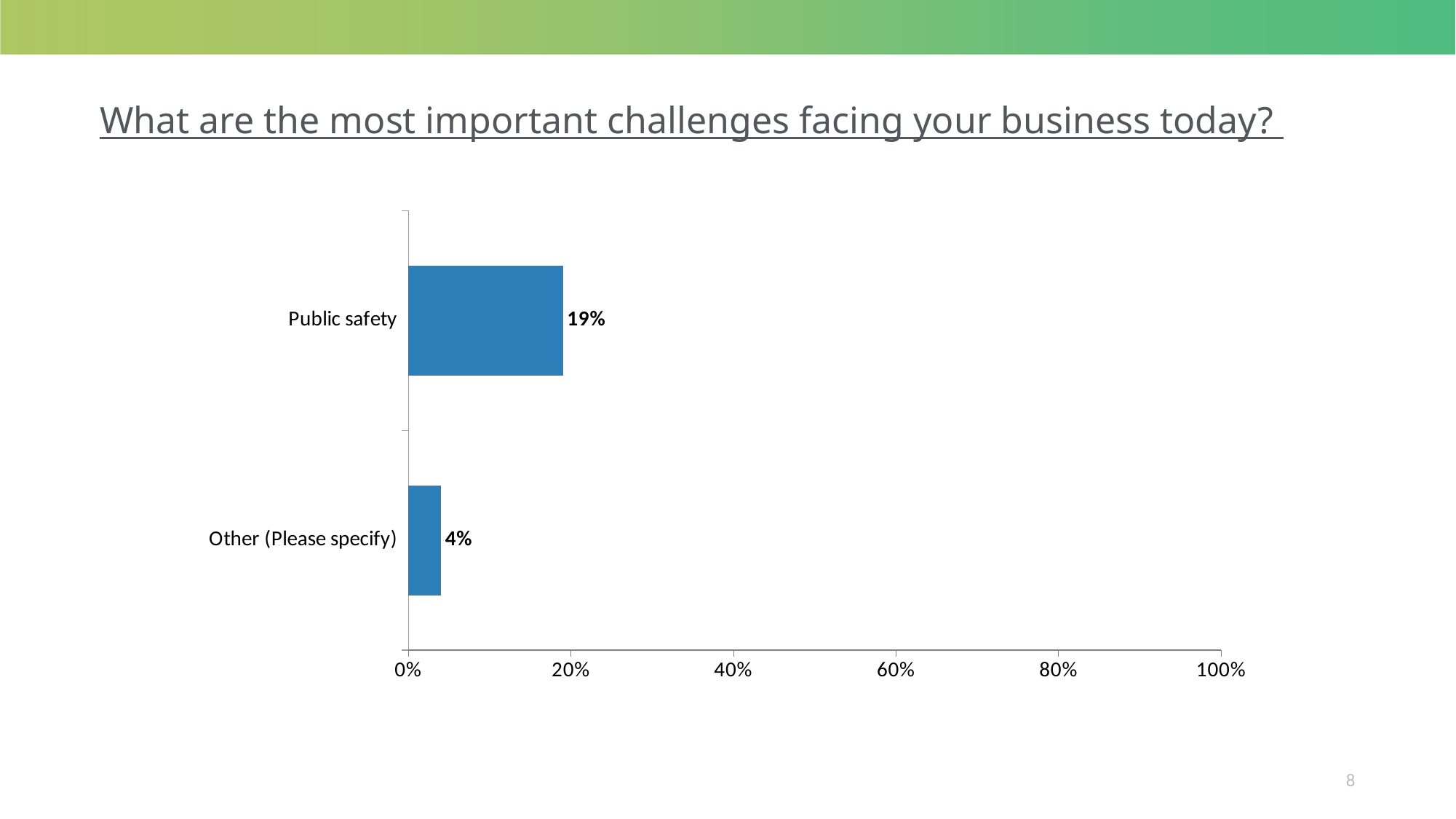
What kind of chart is shown on the slide? Bar chart Which category has the lowest value? Other (Please specify) Which is larger, the value for Public safety or the value for Other (Please specify)? Public safety What is the maximum value shown on the horizontal axis? 100% What is the value for Other (Please specify)? 4% Which category has the highest value? Public safety What is the difference between the values for Public safety and Other (Please specify)? 15% What is the value for Public safety? 19% What is the title of the slide? What are the most important challenges facing your business today? How many categories are shown in the chart? 2 Is the value for Public safety greater or less than 20%? less